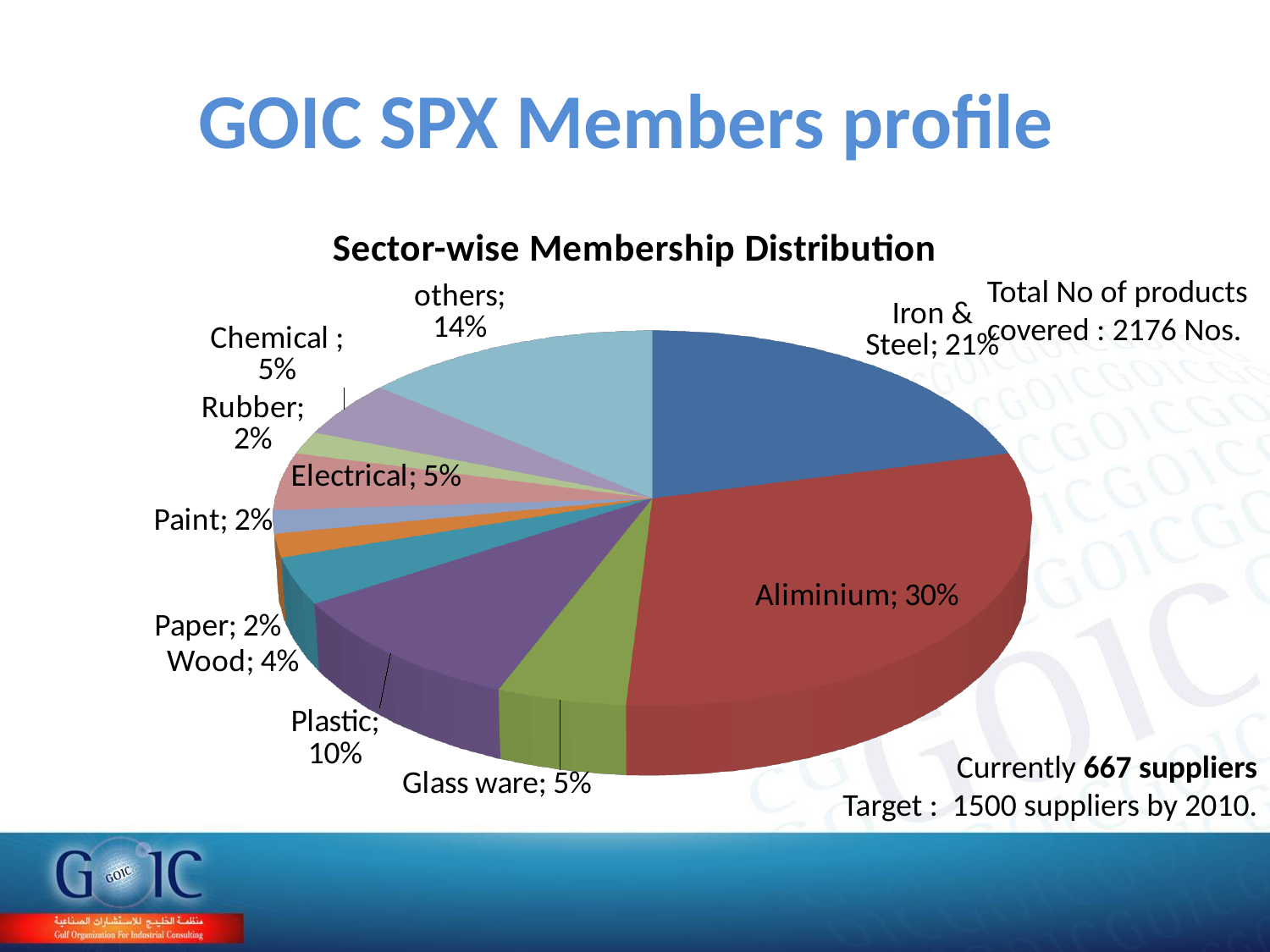
What is the value shown for the 'others' slice? 14% What percentage is shown for Plastic? 10% What is the value shown for Iron & Steel? 21% What is the combined share of Electrical and Chemical? 10% What is the difference between the Aliminium share and the Iron & Steel share? 9% How many slices does the pie chart have? 11 Which is larger, the share for Plastic or the share for Glass ware? Plastic Which sector has the largest share of the pie? Aliminium What is the title of the chart? Sector-wise Membership Distribution What share of the pie does Aliminium hold? 30% What percentage is shown for Wood? 4% What kind of chart is shown on the slide? Pie chart